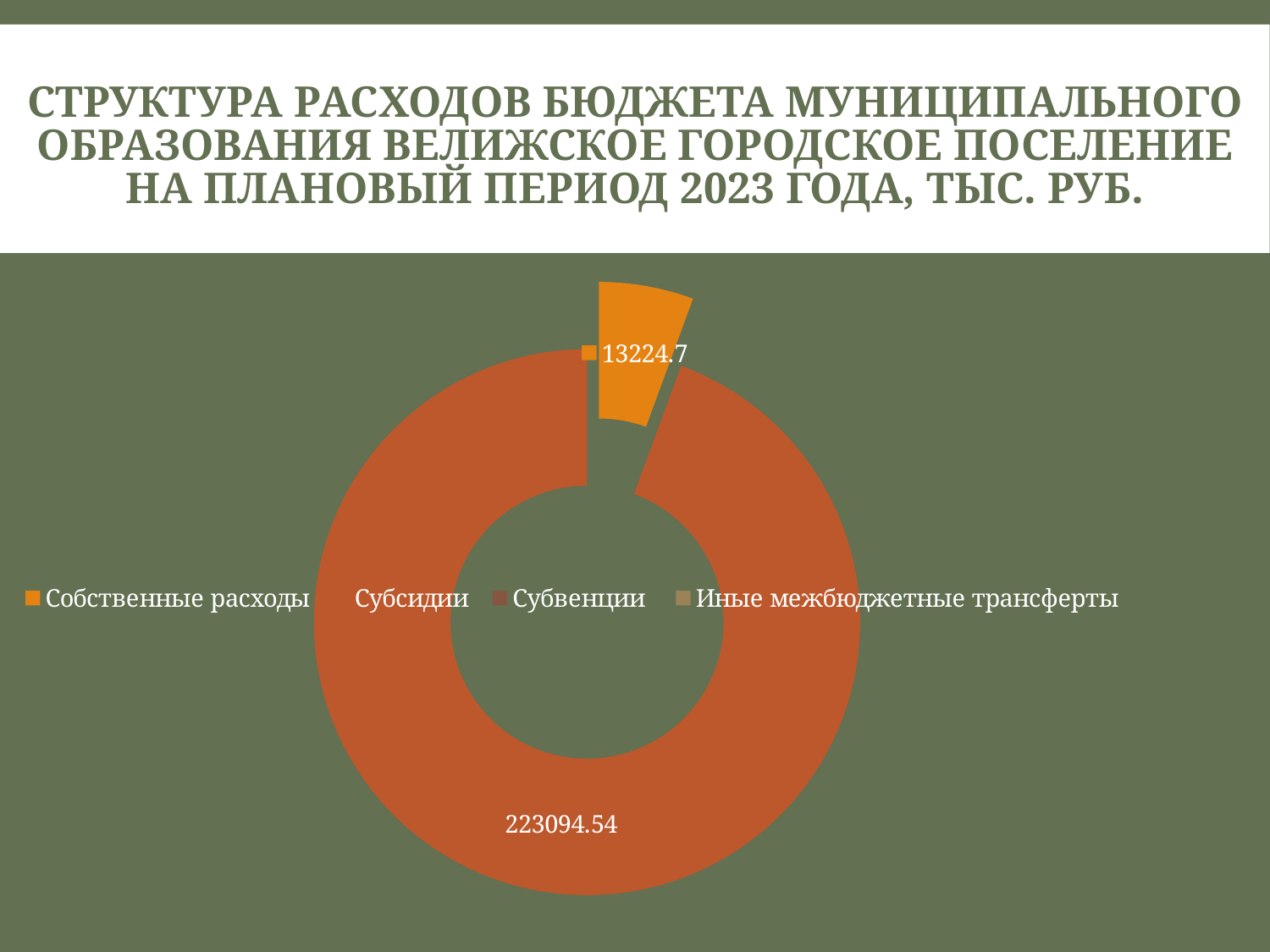
What colour is the slice for Собственные расходы? Orange Which category has the largest slice in the chart? Субсидии In what units are the values on the slide given, according to the title? тыс. руб. How many entries does the legend list? 4 Which of the labelled categories has the smallest value in the chart? Собственные расходы What value is shown for Собственные расходы on the chart? 13224.7 What kind of chart is shown on the slide? Doughnut (pie) chart How many slices with data labels are visible in the chart? 2